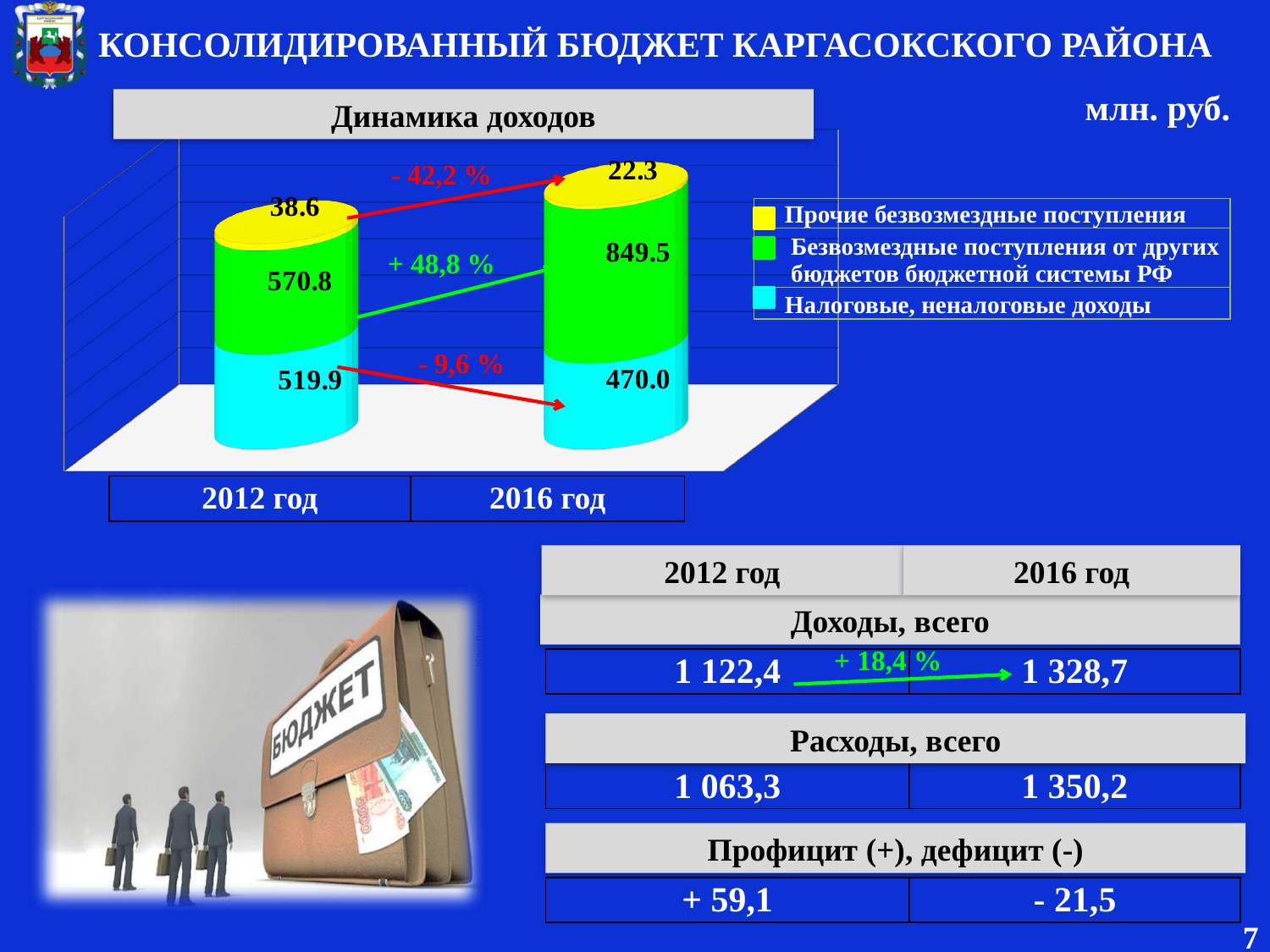
How many series does the legend of the 'Динамика доходов' chart list? 3 In the 'Динамика доходов' chart, what is the value of 'Прочие безвозмездные поступления' for 2016 год? 22.3 In the 'Динамика доходов' chart, by how much did 'Безвозмездные поступления от других бюджетов бюджетной системы РФ' increase from 2012 год to 2016 год? 278.7 In the 'Динамика доходов' chart, what is the value of 'Налоговые, неналоговые доходы' for 2012 год? 519.9 In the 'Динамика доходов' chart, what is the value of 'Прочие безвозмездные поступления' for 2012 год? 38.6 In the 'Динамика доходов' chart, what is the value of 'Безвозмездные поступления от других бюджетов бюджетной системы РФ' for 2016 год? 849.5 In the 'Динамика доходов' chart, what colour represents 'Прочие безвозмездные поступления'? Yellow What kind of chart is 'Динамика доходов'? Stacked bar chart In the 'Динамика доходов' chart, what is the difference between 'Налоговые, неналоговые доходы' in 2012 год and 2016 год? 49.9 In the 'Динамика доходов' chart, is 'Налоговые, неналоговые доходы' larger in 2012 год or 2016 год? 2012 год In the 'Динамика доходов' chart, which series has the smallest value in 2012 год? Прочие безвозмездные поступления In the 'Динамика доходов' chart, which series has the largest value in 2016 год? Безвозмездные поступления от других бюджетов бюджетной системы РФ